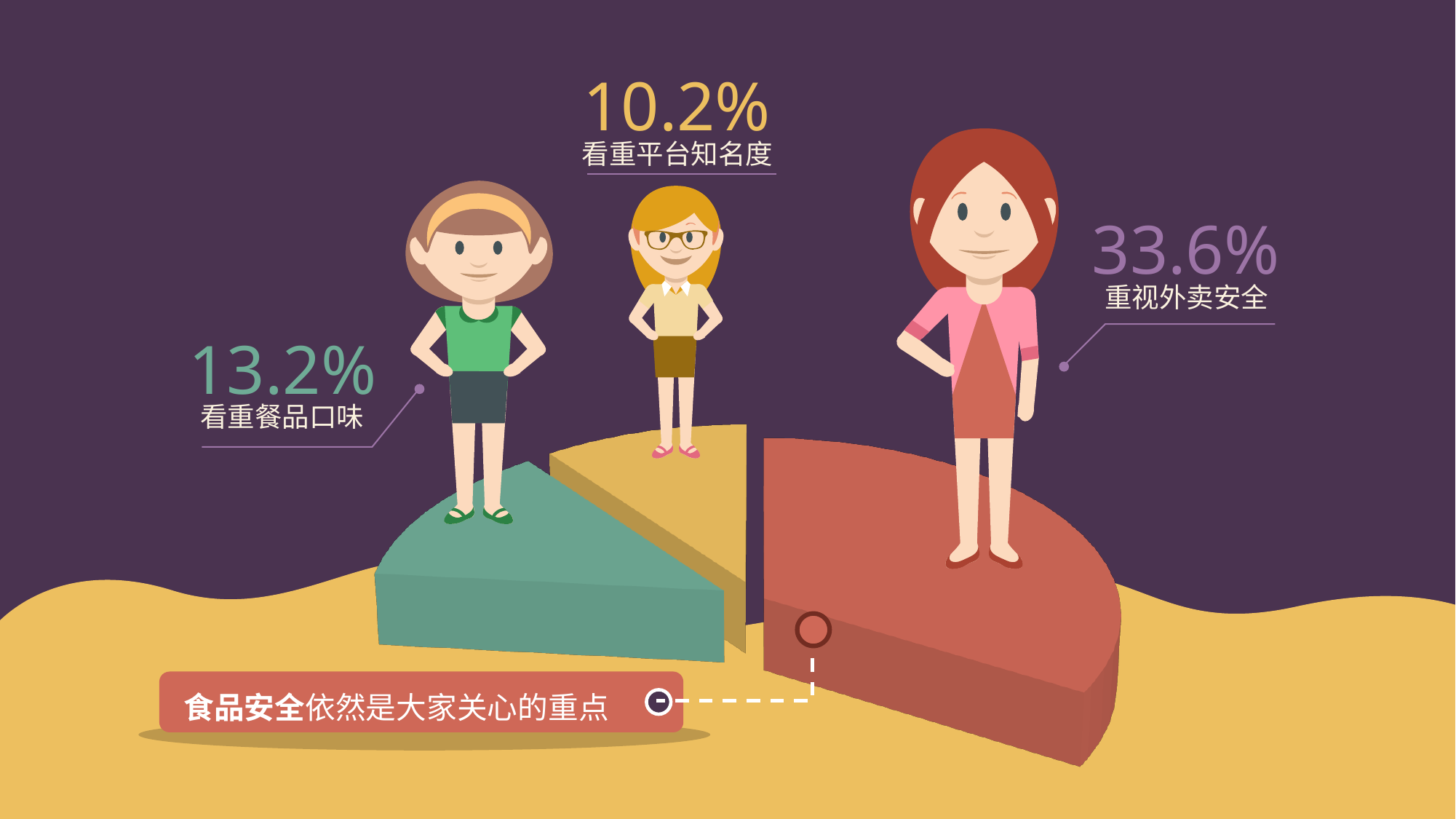
Which category has the largest share in the pie chart? 重视外卖安全 What percentage is shown for 重视外卖安全? 33.6% What does the callout text at the bottom of the chart say? 食品安全依然是大家关心的重点 Which is larger, the share for 看重餐品口味 or the share for 看重平台知名度? 看重餐品口味 What kind of chart is shown on the slide? pie chart What is the difference between the shares for 看重餐品口味 and 看重平台知名度? 3.0% What percentage is shown for 看重平台知名度? 10.2% How many labeled slices does the pie chart have? 3 What is the difference between the shares for 重视外卖安全 and 看重餐品口味? 20.4% Which category has the smallest share in the pie chart? 看重平台知名度 What colour is the slice for 重视外卖安全? red What percentage is shown for 看重餐品口味? 13.2%